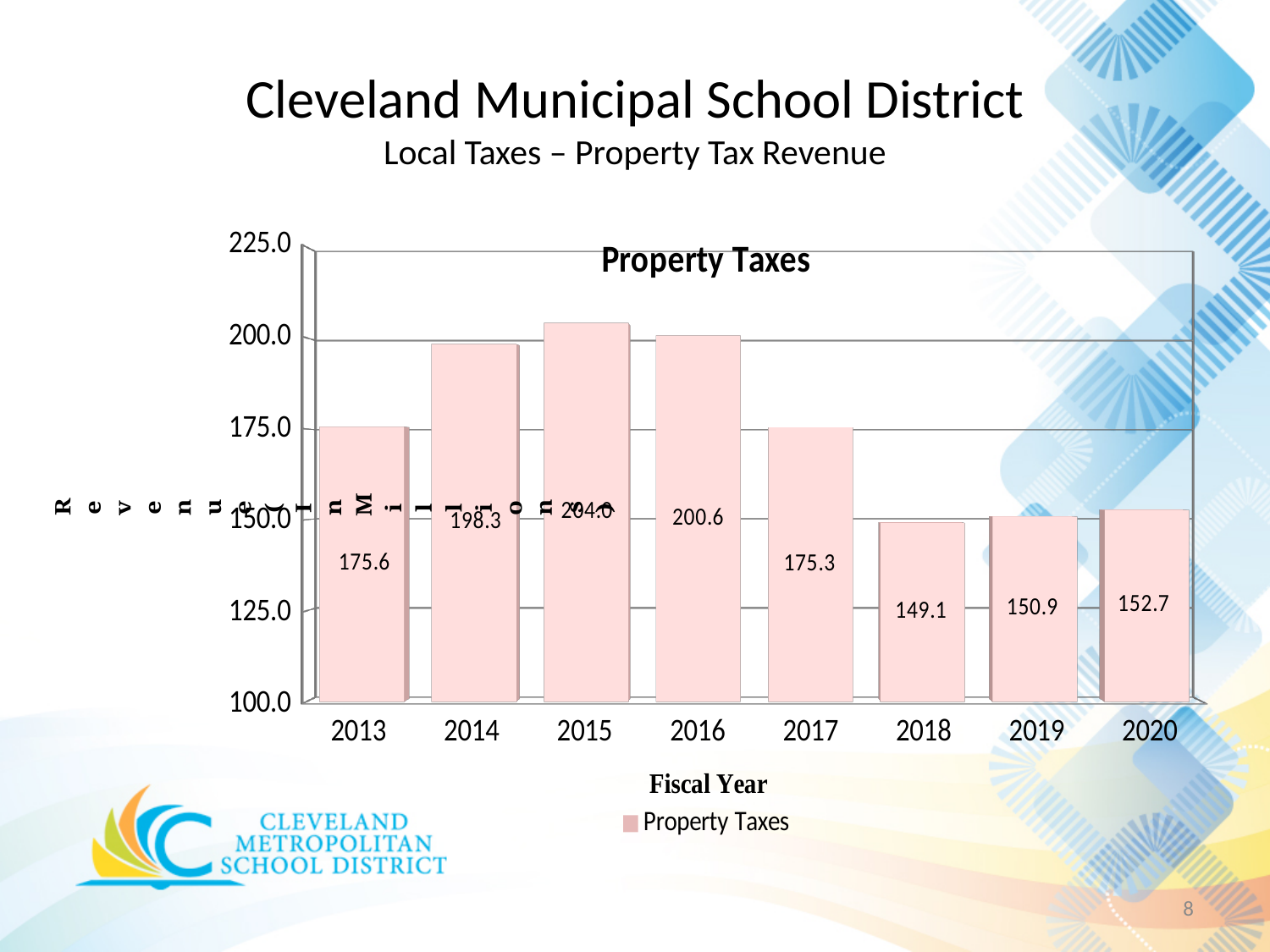
What is the difference between the Property Taxes values for 2020 and 2018? 3.6 What is the Property Taxes value for fiscal year 2018? 149.1 How many fiscal years are shown on the x axis of the chart? 8 Is the Property Taxes value for 2017 greater or less than 200.0? less How many series does the chart legend list? 1 What kind of chart is shown on the slide? bar chart Which fiscal year has the highest Property Taxes value? 2015 What is the Property Taxes value for fiscal year 2013? 175.6 What is the Property Taxes value for fiscal year 2020? 152.7 What is the difference between the Property Taxes values for 2014 and 2013? 22.7 Which fiscal year has the lowest Property Taxes value? 2018 Which fiscal year has a larger Property Taxes value, 2016 or 2017? 2016